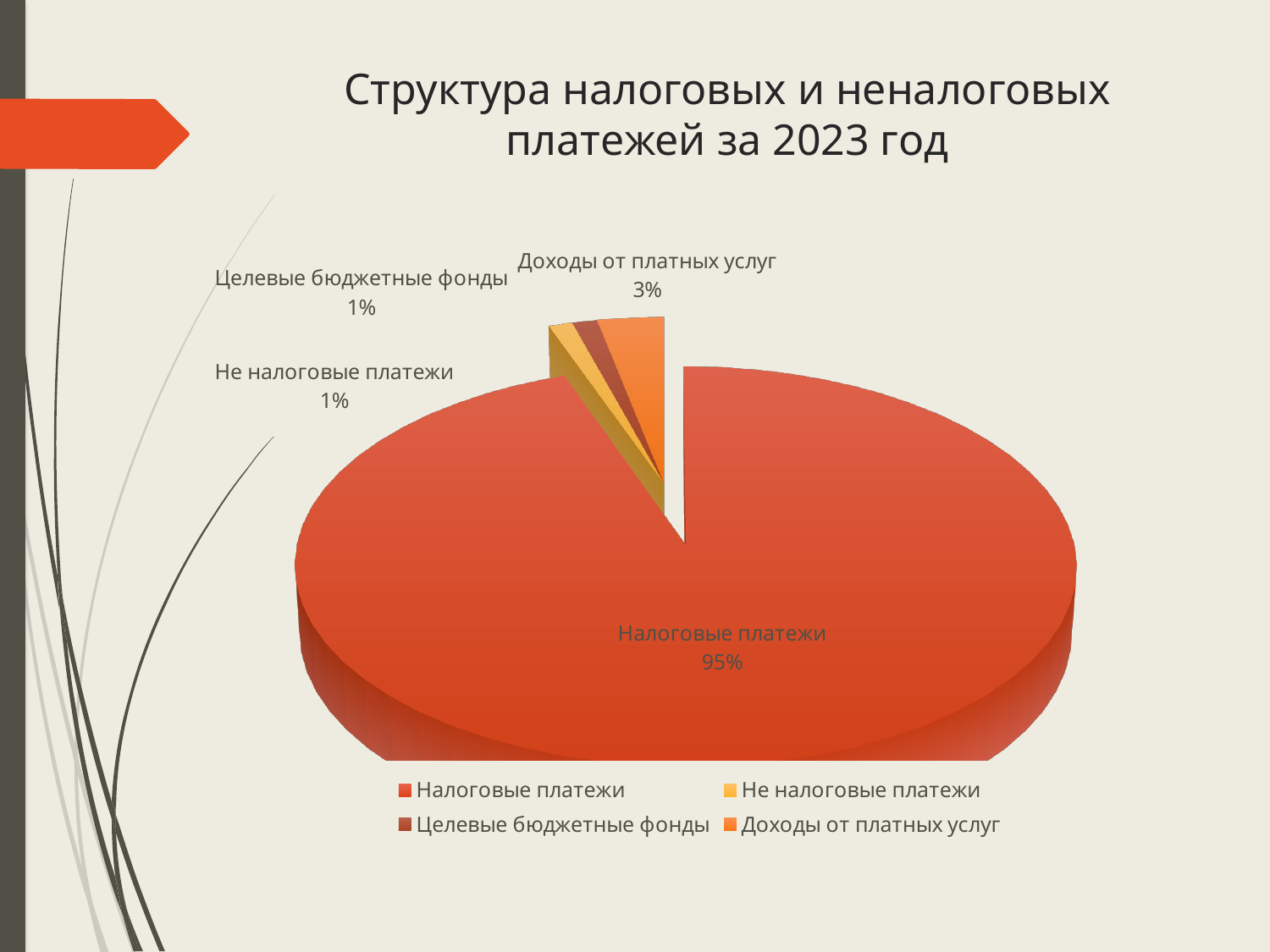
How many categories does the pie chart show? 4 What is the difference in percentage points between Налоговые платежи and Доходы от платных услуг? 92 What share of the pie does Налоговые платежи have? 95% What share of the pie does Целевые бюджетные фонды have? 1% Which category has the largest slice of the pie? Налоговые платежи What share of the pie does Доходы от платных услуг have? 3% What share of the pie does Не налоговые платежи have? 1% What kind of chart is shown on the slide? Pie chart Which is larger: Доходы от платных услуг or Целевые бюджетные фонды? Доходы от платных услуг What is the title of the chart? Структура налоговых и неналоговых платежей за 2023 год How many entries does the legend list? 4 What is the combined share of Не налоговые платежи and Целевые бюджетные фонды? 2%